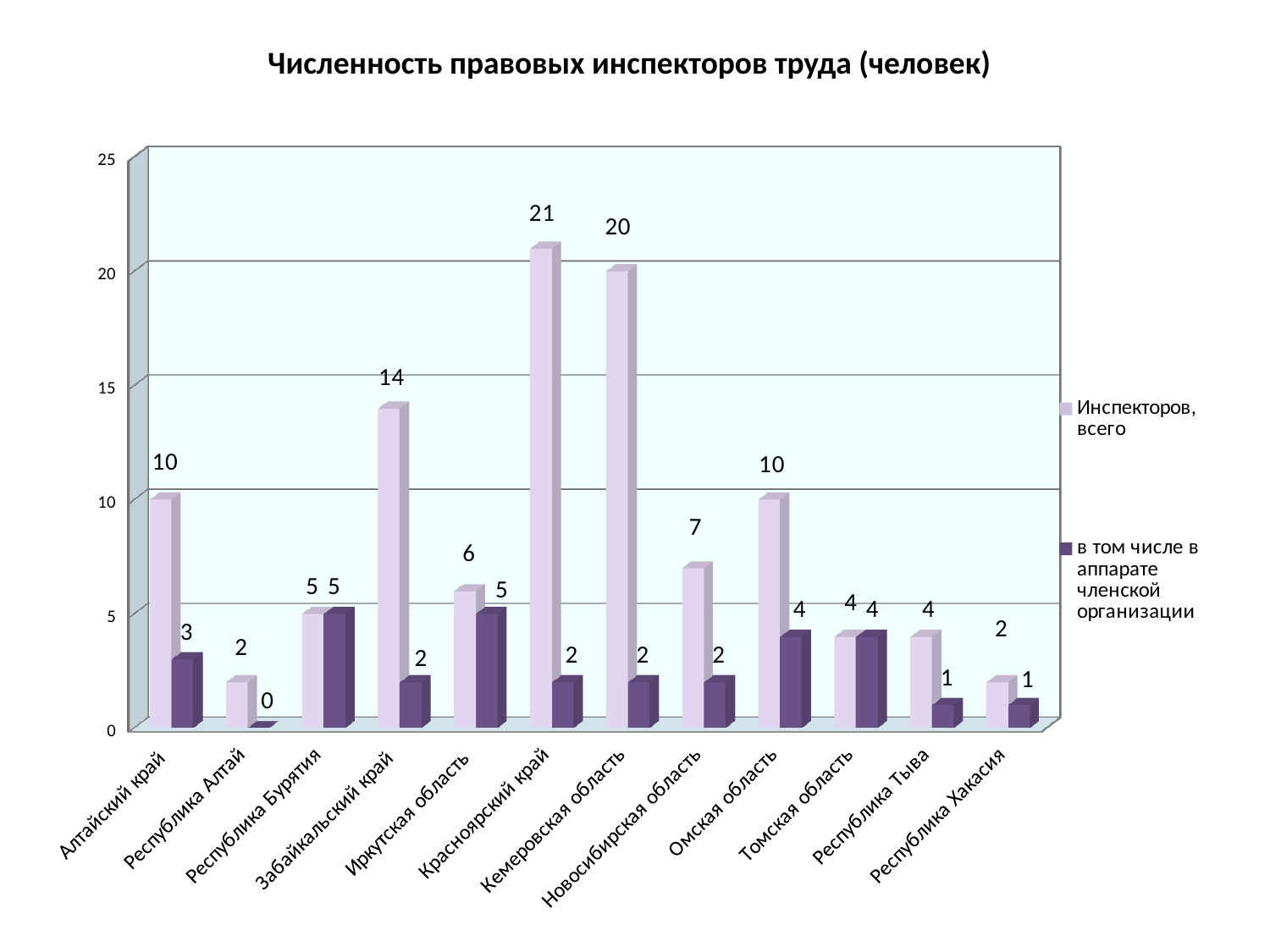
How many series does the legend list? 2 How many regions are shown on the x axis? 12 What is the value of "Инспекторов, всего" for Забайкальский край? 14 What is the value of "Инспекторов, всего" for Красноярский край? 21 Which is larger: "Инспекторов, всего" for Забайкальский край or for Омская область? Забайкальский край What is the difference between "Инспекторов, всего" and "в том числе в аппарате членской организации" for Алтайский край? 7 Which region has the lowest value for "в том числе в аппарате членской организации"? Республика Алтай What is the value of "в том числе в аппарате членской организации" for Омская область? 4 Which region has the highest value for "Инспекторов, всего"? Красноярский край What kind of chart is shown on the slide? Bar chart What is the difference between "Инспекторов, всего" for Красноярский край and Кемеровская область? 1 What is the title of the chart? Численность правовых инспекторов труда (человек)